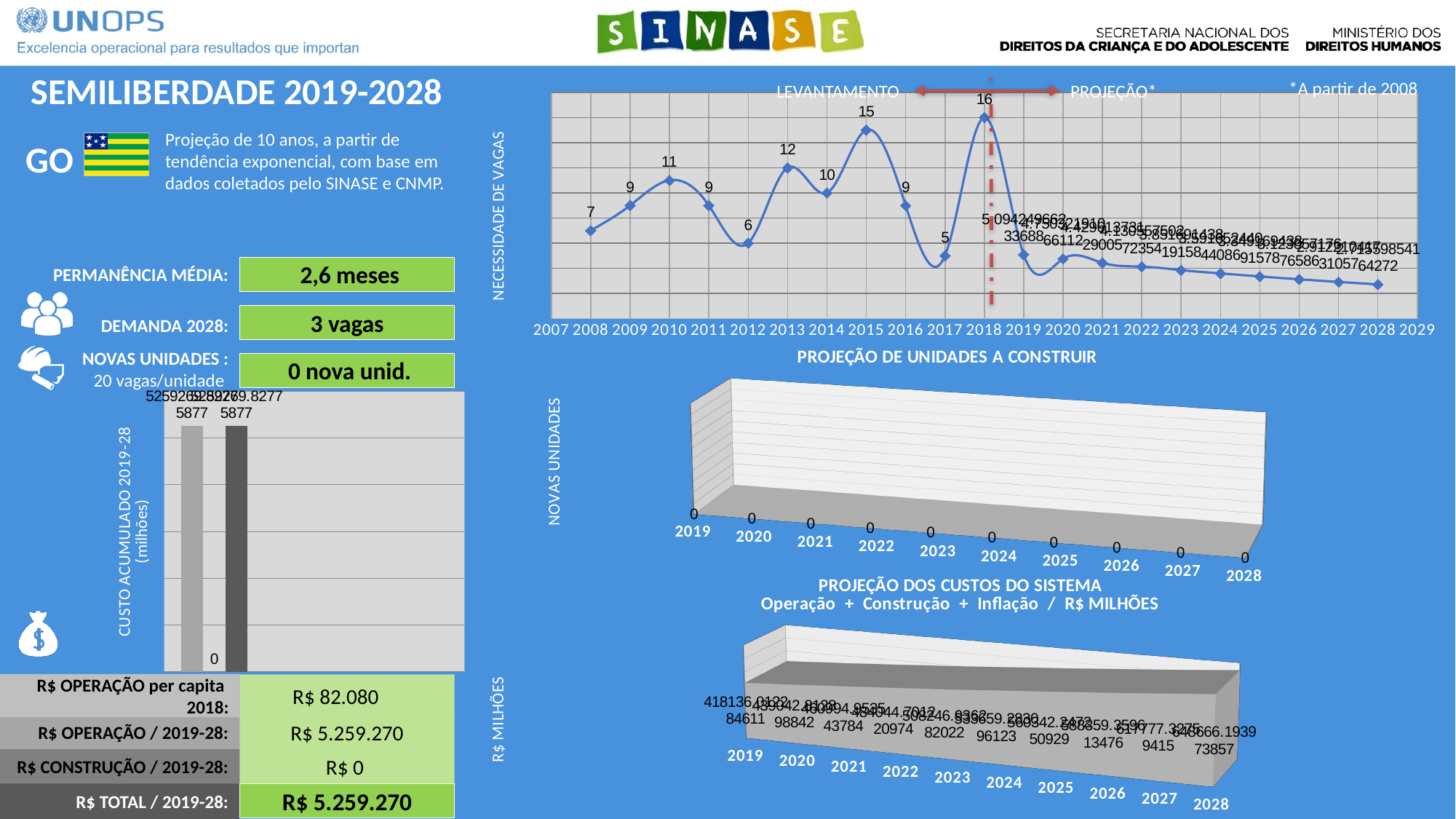
In the chart titled PROJEÇÃO DE UNIDADES A CONSTRUIR, how many years are shown on the x axis? 10 What is the title of the chart in the middle of the right side of the slide? PROJEÇÃO DE UNIDADES A CONSTRUIR In the top line chart (NECESSIDADE DE VAGAS), what is the value for 2012? 6 In the top line chart (NECESSIDADE DE VAGAS), what is the value for 2015? 15 In the top line chart (NECESSIDADE DE VAGAS), what is the difference between the values for 2018 and 2017? 11 What kind of chart is the top chart labelled NECESSIDADE DE VAGAS? line chart In the top line chart (NECESSIDADE DE VAGAS), which year has the larger value, 2013 or 2014? 2013 In the top line chart (NECESSIDADE DE VAGAS), what is the value for 2017? 5 In the chart titled PROJEÇÃO DE UNIDADES A CONSTRUIR, what is the value for 2024? 0 In the top line chart (NECESSIDADE DE VAGAS), what is the value for 2018? 16 In the top line chart (NECESSIDADE DE VAGAS), which year has the highest value? 2018 In the top line chart (NECESSIDADE DE VAGAS), do the values rise or fall from 2019 to 2028? fall